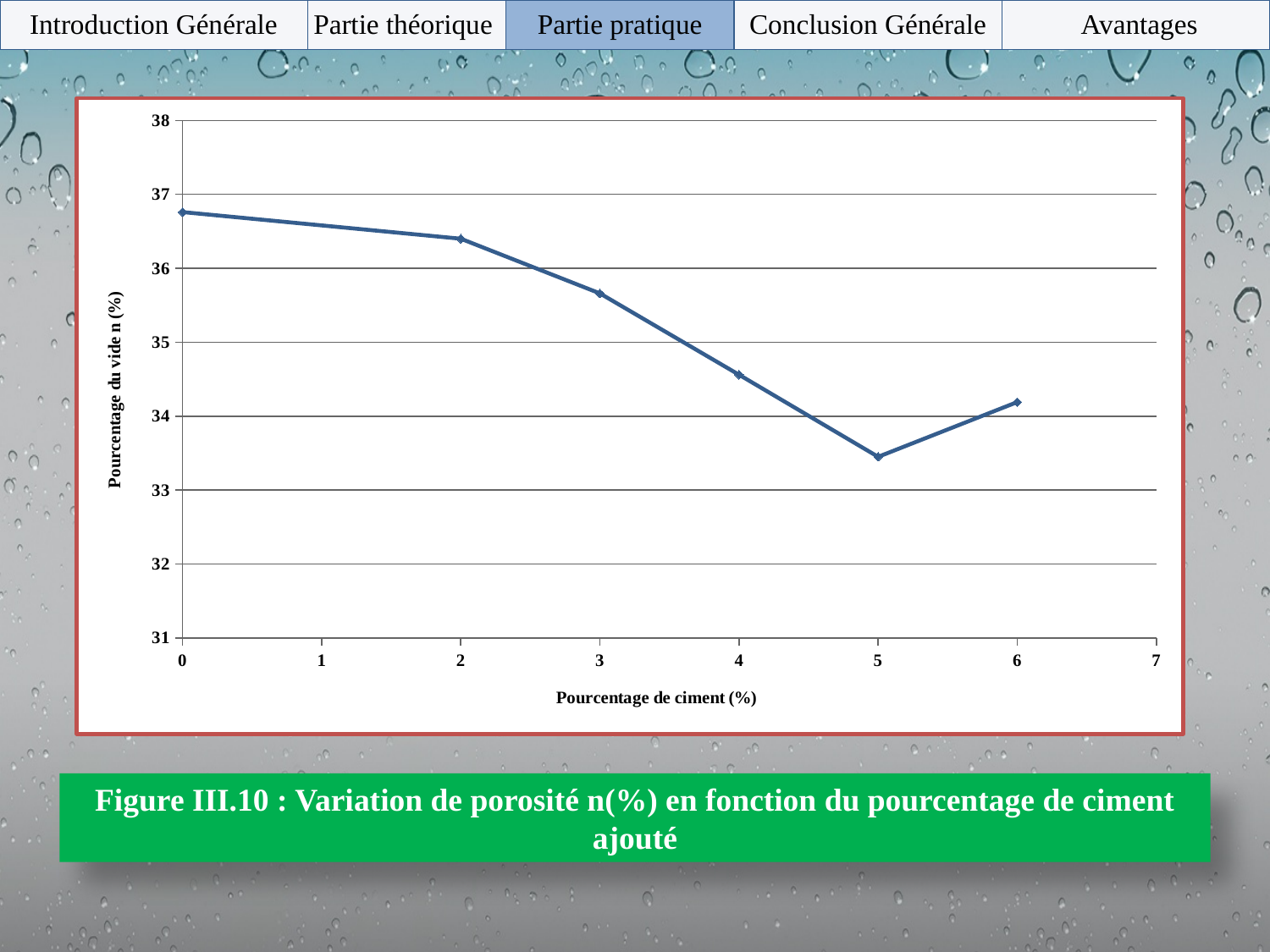
What is the label of the y axis? Pourcentage du vide n (%) Is the porosity value at 3% cement greater or less than 35? greater What kind of chart is shown on the slide? line chart Which has the higher porosity value: 2% cement or 6% cement? 2% cement What is the label of the x axis? Pourcentage de ciment (%) At which cement percentage is the porosity (pourcentage du vide) highest? 0 How many data points are plotted on the line? 6 At which cement percentage is the porosity (pourcentage du vide) lowest? 5 Does the porosity rise or fall as the cement percentage increases from 0 to 5? fall Is the porosity value at 0% cement greater or less than 36? greater Is the porosity value at 5% cement greater or less than 34? less